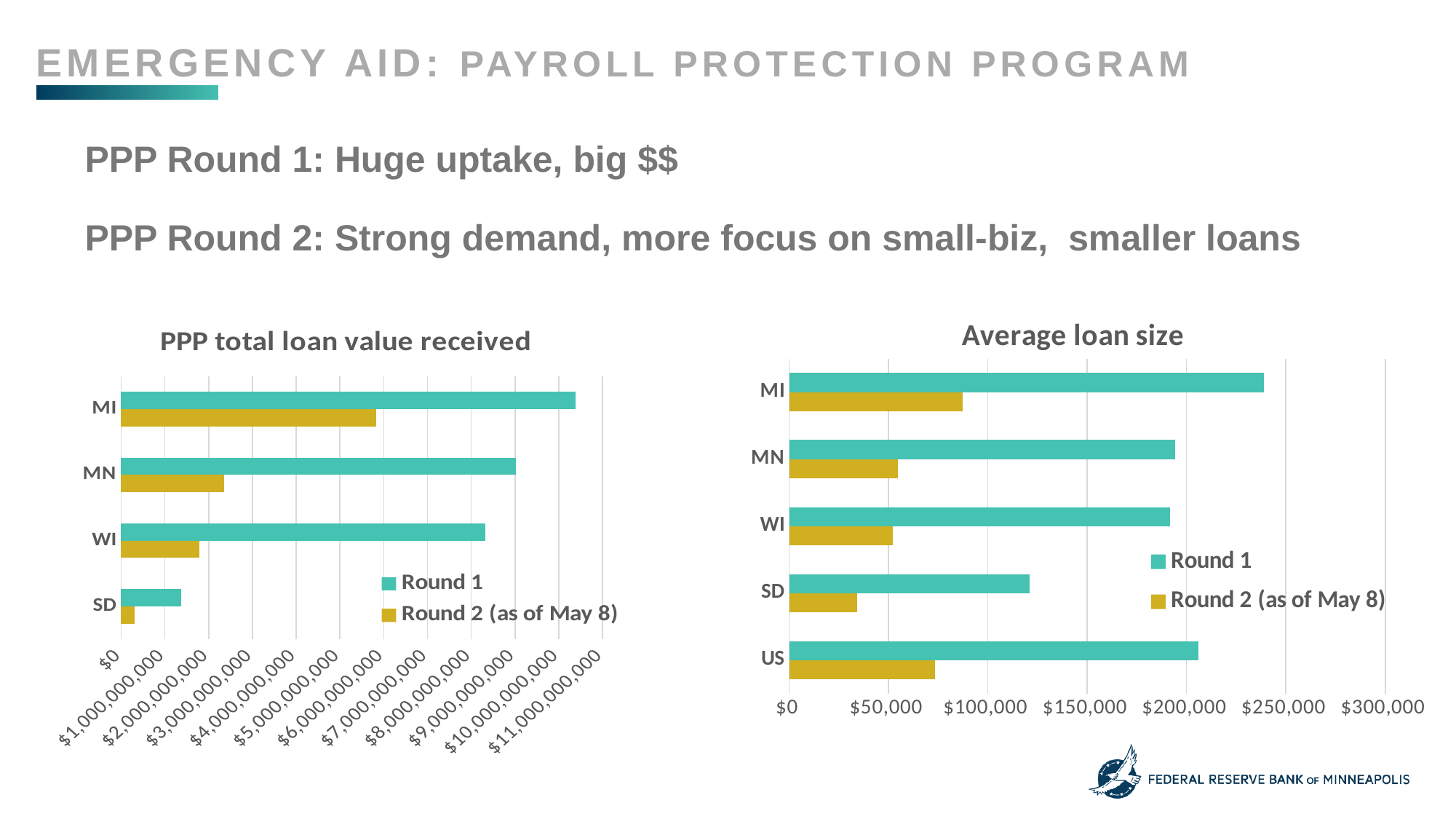
How many categories are shown on the 'Average loan size' chart? 5 How many states are shown on the 'PPP total loan value received' chart? 4 On the 'Average loan size' chart, which category has the highest Round 1 average loan size? MI On the 'PPP total loan value received' chart, which is larger for Round 2 (as of May 8): MN or WI? MN On the 'PPP total loan value received' chart, is the Round 1 value for MI greater or less than $10,000,000,000? greater On the 'PPP total loan value received' chart, is the Round 2 (as of May 8) value for MI greater or less than $6,000,000,000? less On the 'PPP total loan value received' chart, which state has the lowest Round 1 value? SD How many series does the legend of the 'Average loan size' chart list? 2 On the 'Average loan size' chart, is the Round 2 (as of May 8) value for SD greater or less than $50,000? less On the 'Average loan size' chart, which category has the lowest Round 2 (as of May 8) average loan size? SD On the 'PPP total loan value received' chart, which state has the highest Round 1 value? MI